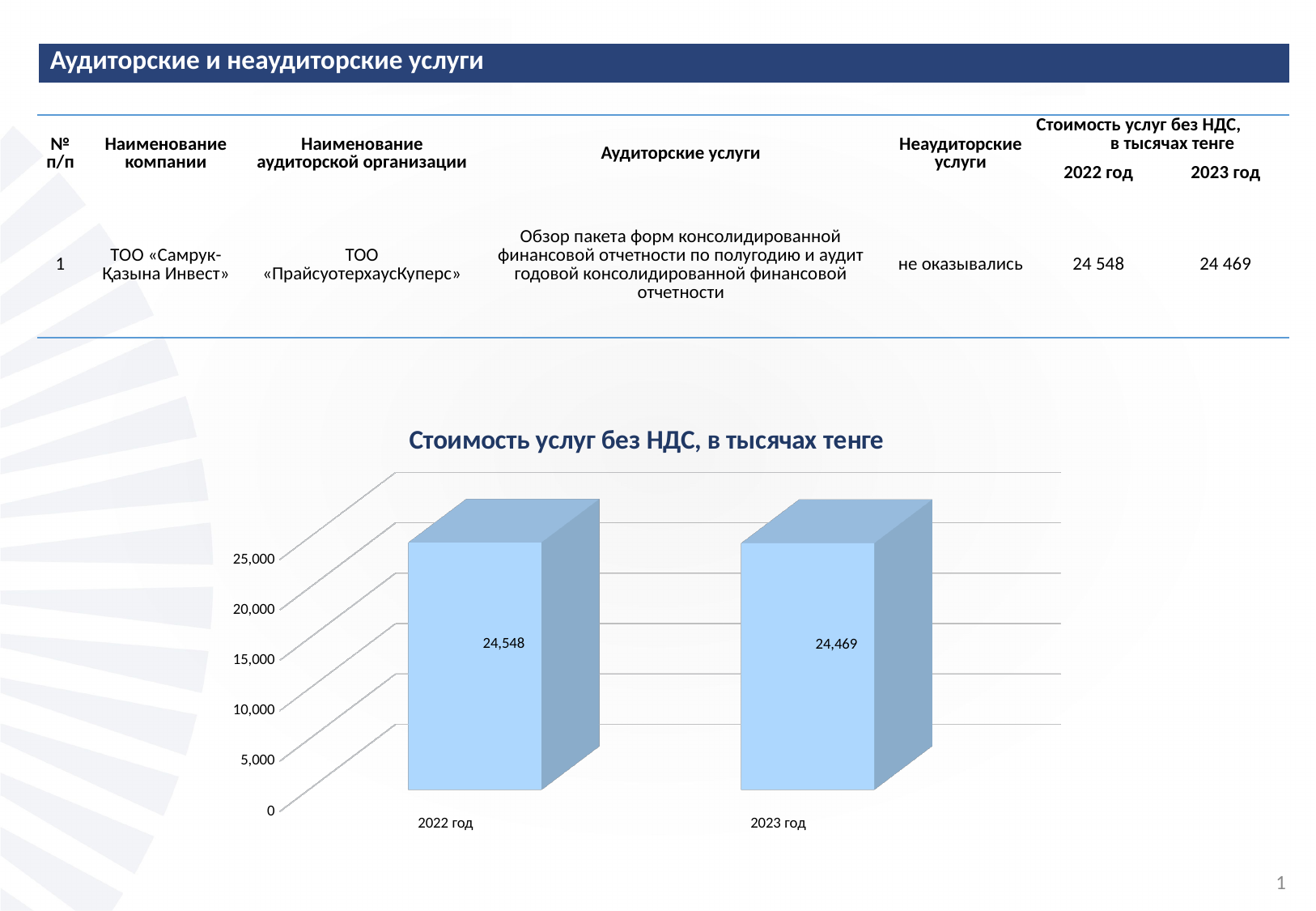
Is the value for 2022 год greater or less than 20,000? greater Is the value for 2023 год greater or less than 25,000? less What is the highest tick value shown on the vertical axis of the chart? 25,000 What kind of chart is shown on the slide? bar chart Do the values rise or fall from 2022 год to 2023 год in the chart? fall What is the value for 2022 год in the chart? 24,548 What is the value for 2023 год in the chart? 24,469 What is the difference between the values for 2022 год and 2023 год in the chart? 79 How many categories are shown in the chart? 2 Which year has the higher value in the chart, 2022 год or 2023 год? 2022 год What is the title of the chart? Стоимость услуг без НДС, в тысячах тенге Which category has the lowest value in the chart? 2023 год